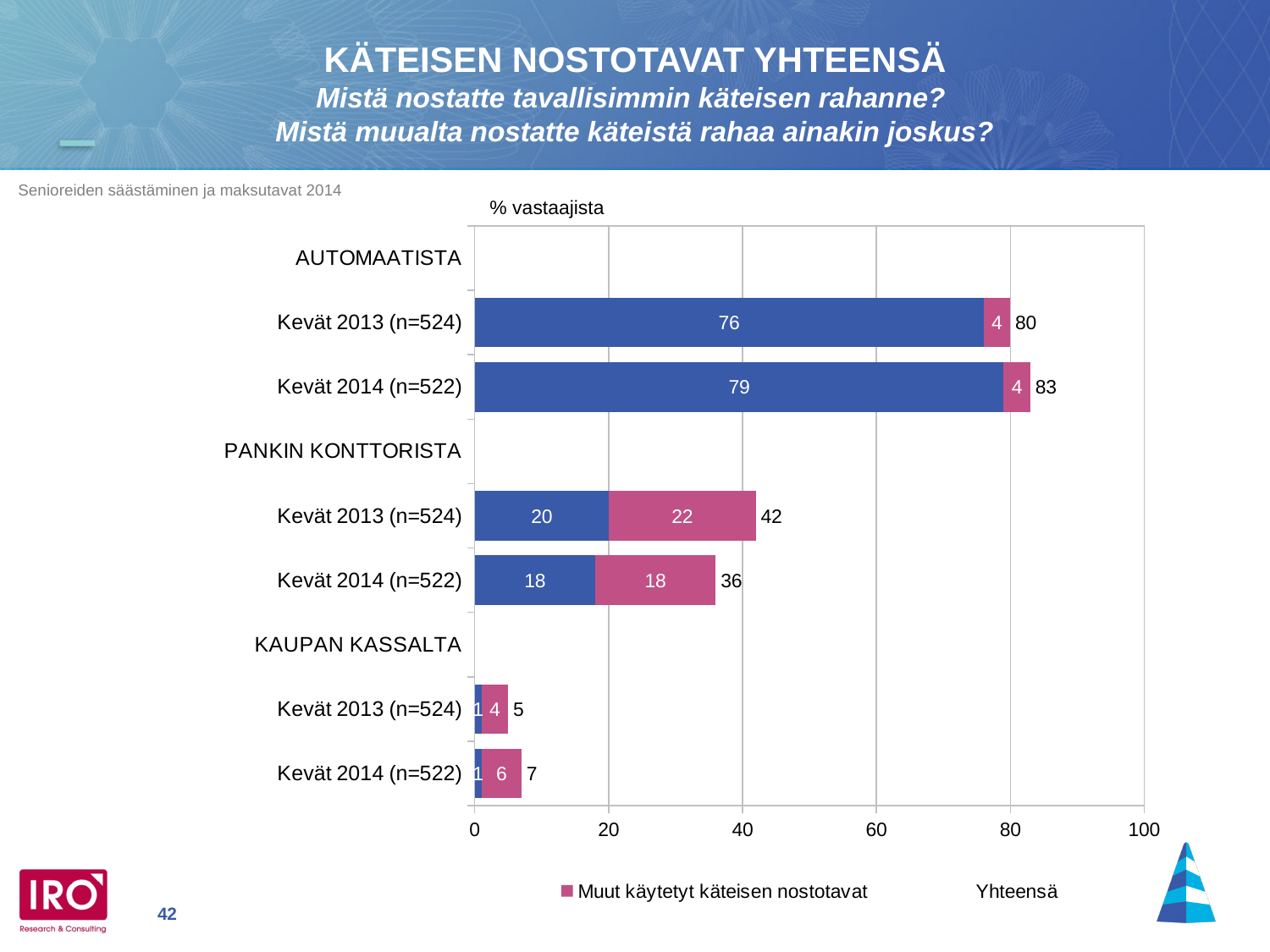
Is the total for Kevät 2014 (n=522) under AUTOMAATISTA greater or less than 80? greater What is the difference between the total for Kevät 2013 (n=524) and Kevät 2014 (n=522) under PANKIN KONTTORISTA? 6 Which bar has the lowest total value? KAUPAN KASSALTA, Kevät 2013 (n=524) What is the axis title shown above the chart? % vastaajista Which bar has the highest total value? AUTOMAATISTA, Kevät 2014 (n=522) What is the value of the 'Muut käytetyt käteisen nostotavat' segment for Kevät 2013 (n=524) under PANKIN KONTTORISTA? 22 Under PANKIN KONTTORISTA, which is larger: the total for Kevät 2013 (n=524) or for Kevät 2014 (n=522)? Kevät 2013 (n=524) What kind of chart is shown on the slide? bar chart What is the total value shown for Kevät 2014 (n=522) under AUTOMAATISTA? 83 What is the value of the blue segment for Kevät 2013 (n=524) under AUTOMAATISTA? 76 What is the sum of the two segments for Kevät 2014 (n=522) under KAUPAN KASSALTA? 7 What is the total value shown for Kevät 2014 (n=522) under KAUPAN KASSALTA? 7